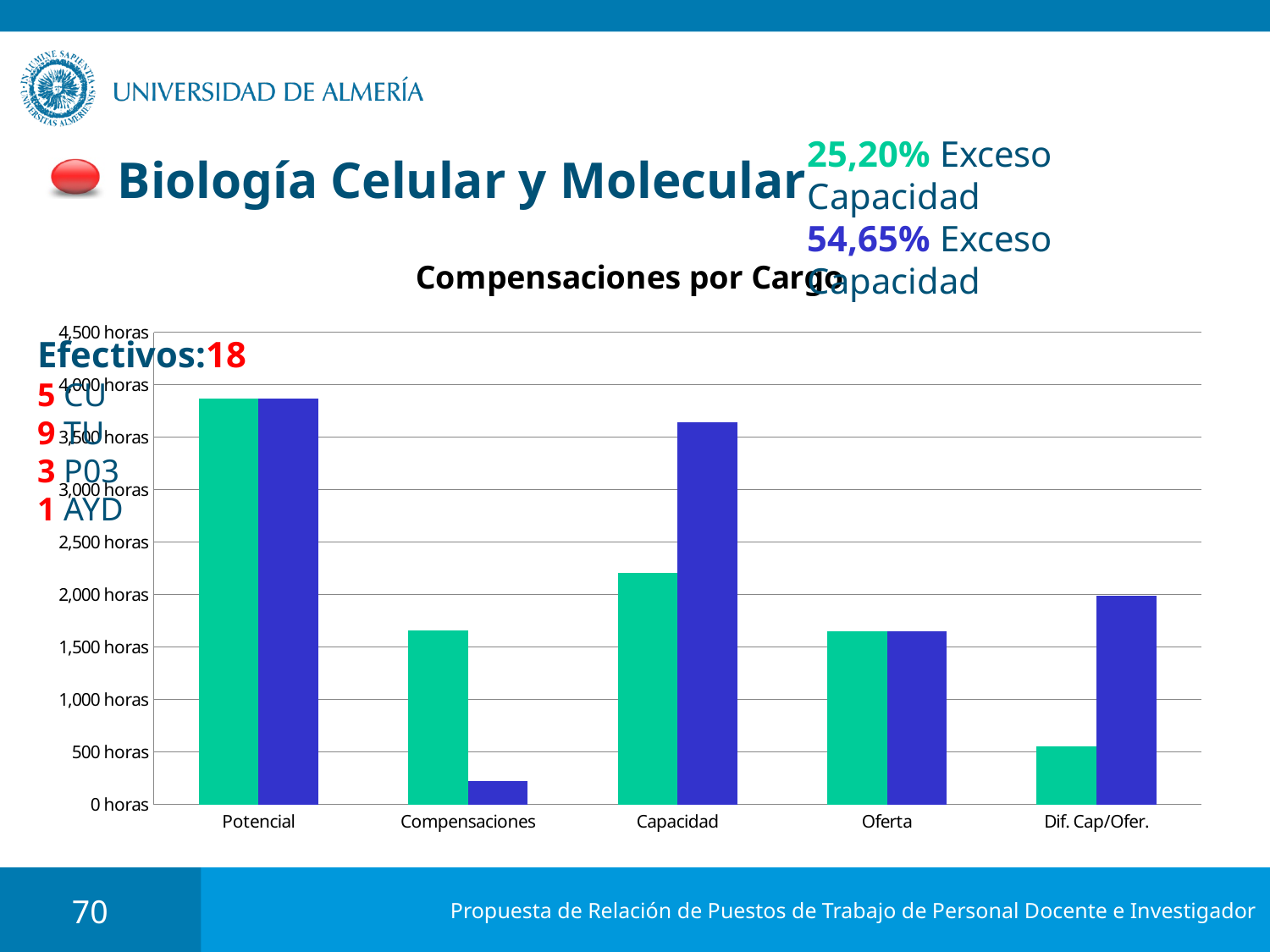
For Compensaciones, which bar is taller, the green one or the blue one? the green one Is the green bar for Capacidad greater or less than 2,000 horas? greater What is the title of the chart? Compensaciones por Cargo Is the green bar for Dif. Cap/Ofer. greater or less than 1,000 horas? less What kind of chart is shown on the slide? bar chart For Capacidad, which bar is taller, the green one or the blue one? the blue one Is the green bar for Potencial greater or less than 3,500 horas? greater How many categories are shown on the x axis of the chart? 5 Which category has the tallest green bar? Potencial Which category has the shortest blue bar? Compensaciones How many bars are plotted for each category in the chart? 2